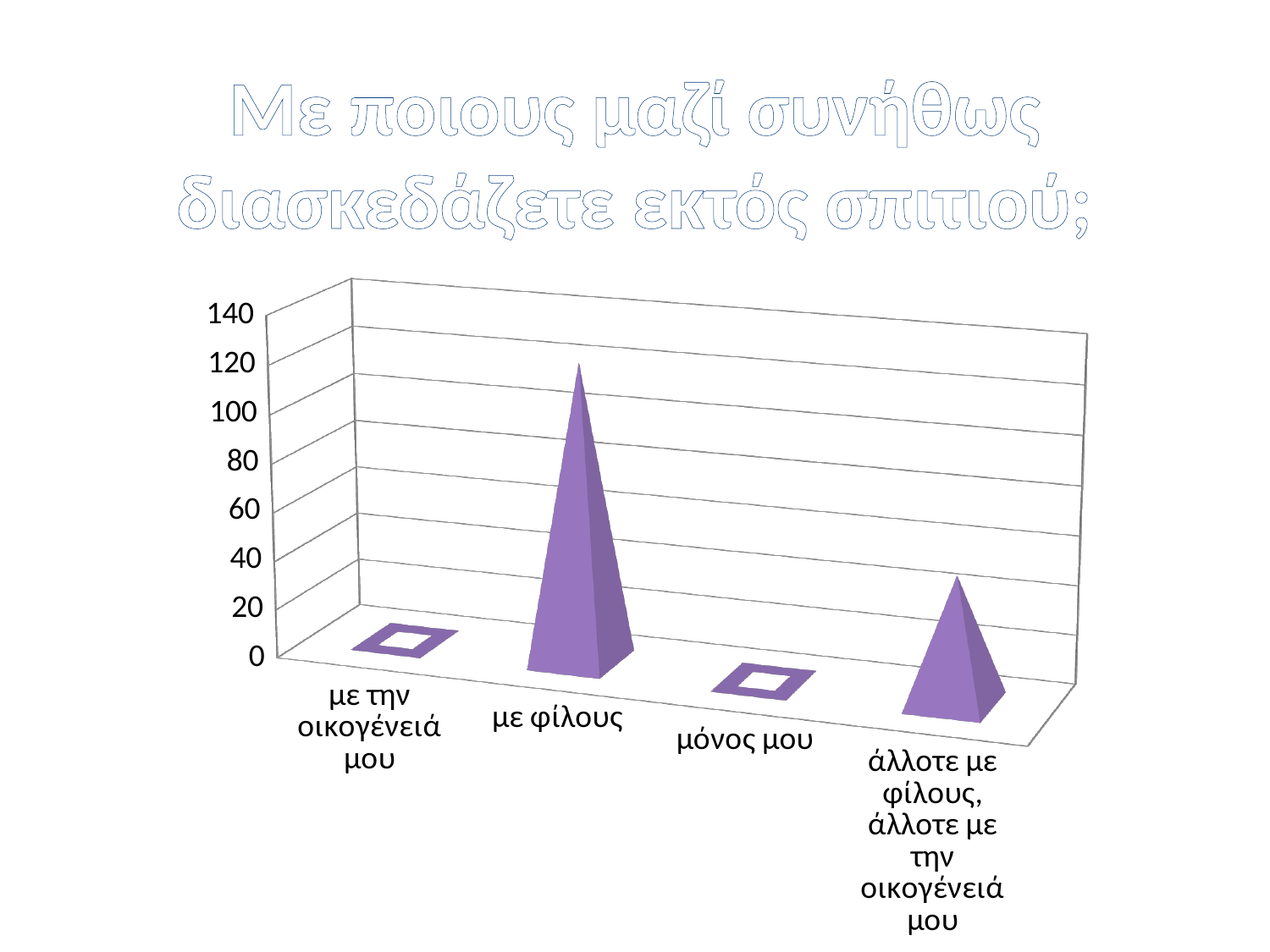
What kind of chart is shown on the slide? bar chart How many categories are shown on the x axis of the chart? 4 Is the value for "με φίλους" greater or less than 80? greater Is the value for "μόνος μου" greater or less than 20? less Is the value for "άλλοτε με φίλους, άλλοτε με την οικογένειά μου" greater or less than 20? greater What is the highest value shown on the vertical axis of the chart? 140 Which is larger, the value for "με φίλους" or the value for "άλλοτε με φίλους, άλλοτε με την οικογένειά μου"? με φίλους What is the title of the chart on the slide? Με ποιους μαζί συνήθως διασκεδάζετε εκτός σπιτιού; Which category has the highest value in the chart? με φίλους